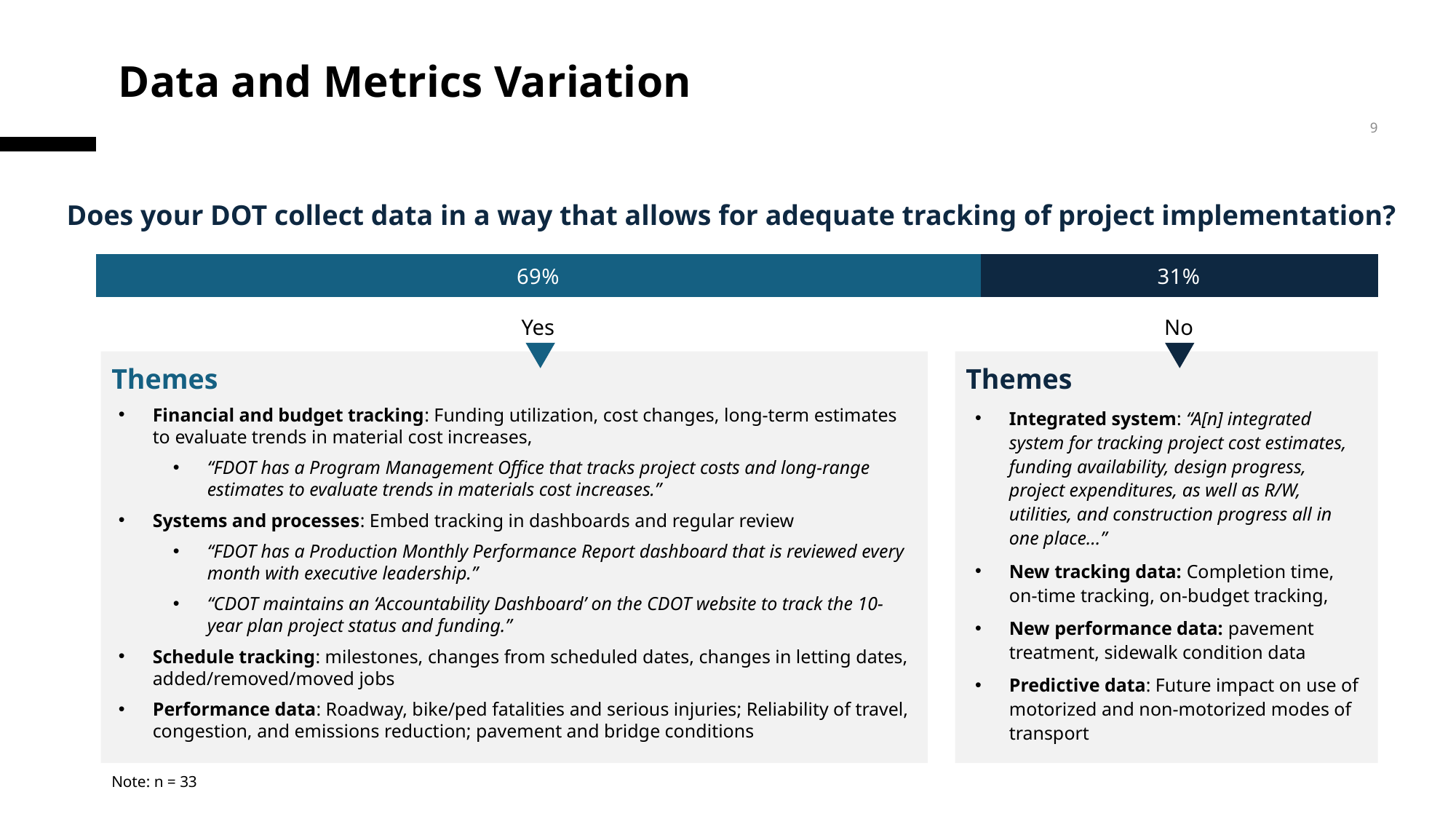
What percentage of respondents answered No? 31% What is the difference in percentage points between the Yes and No responses? 38 Which segment of the bar is shown in the darker navy colour? No What kind of chart is used to show the Yes/No responses? bar chart What is the total of the two segments in the stacked bar? 100% Which response has the smallest share? No Is the share for Yes larger or smaller than the share for No? larger How many response categories are shown in the bar? 2 What percentage of respondents answered Yes to whether their DOT collects data in a way that allows for adequate tracking of project implementation? 69% What is the sample size noted for the survey question? n = 33 Which response, Yes or No, has the larger share? Yes